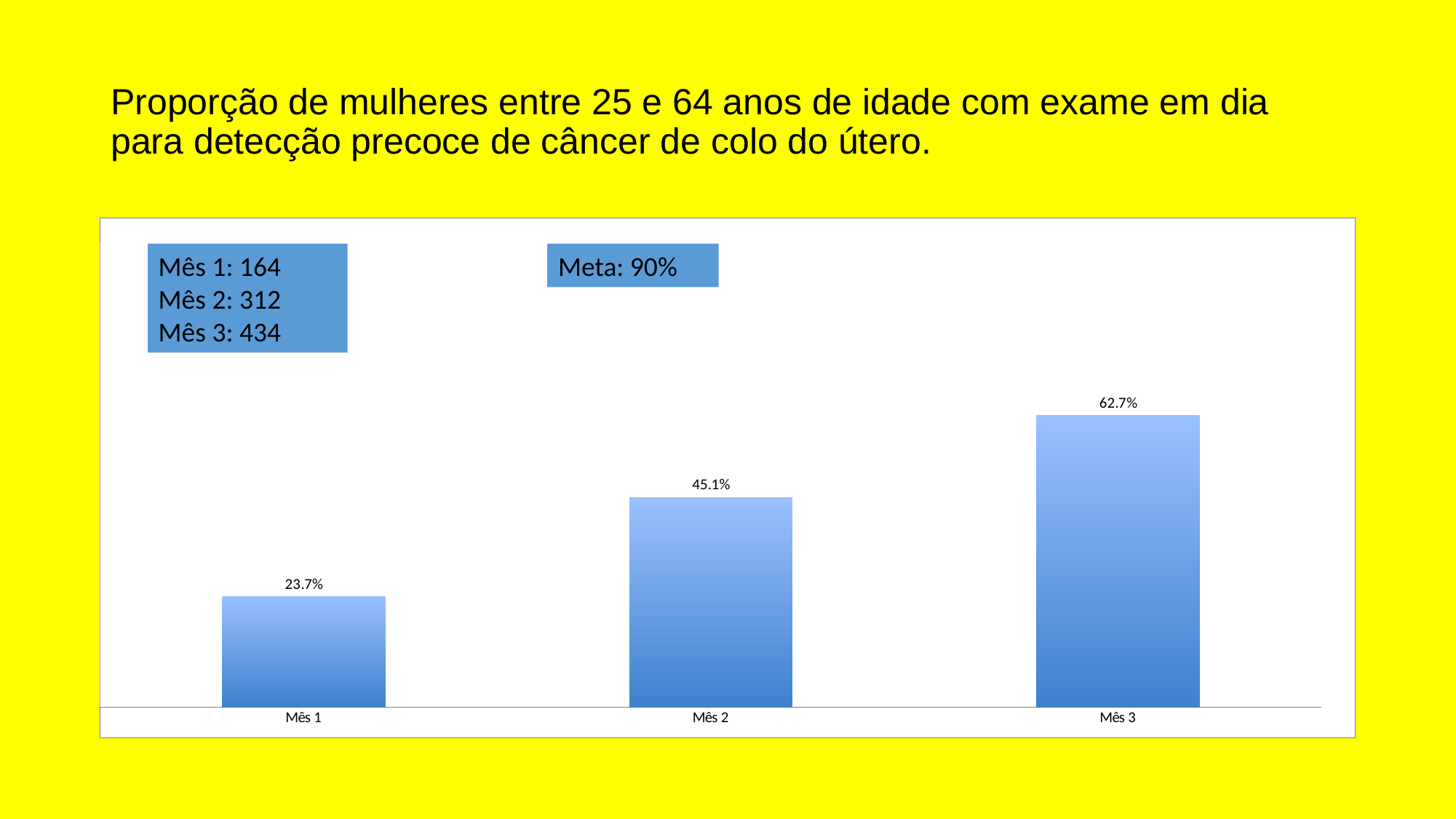
What target (Meta) is stated in the box on the chart? 90% How many bars are plotted in the chart? 3 Do the values rise or fall from Mês 1 to Mês 3? Rise What is the value shown for Mês 1? 23.7% Which month has the lowest value? Mês 1 Which is larger, the value for Mês 2 or the value for Mês 3? Mês 3 What kind of chart is shown on the slide? Bar chart What is the value shown for Mês 2? 45.1% What is the difference between the values for Mês 2 and Mês 1? 21.4% What is the value shown for Mês 3? 62.7% Which month has the highest value? Mês 3 What is the difference between the values for Mês 3 and Mês 2? 17.6%